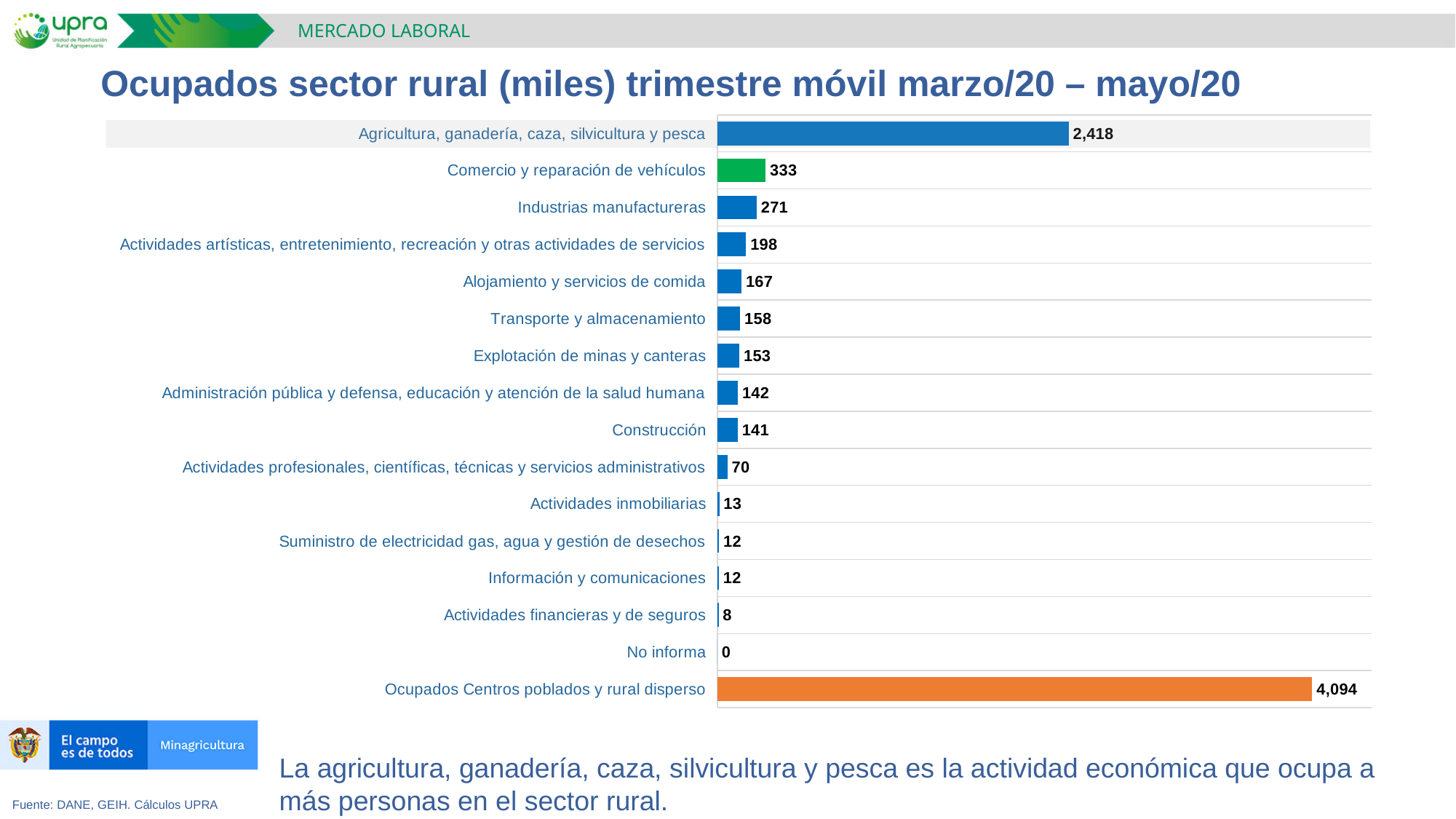
What is the value for Ocupados Centros poblados y rural disperso? 4,094 What is the difference between Industrias manufactureras and Comercio y reparación de vehículos? 62 Which is larger, Transporte y almacenamiento or Explotación de minas y canteras? Transporte y almacenamiento Which category has the lowest value in the chart? No informa What is the value for Construcción? 141 What is the value for Comercio y reparación de vehículos? 333 What is the title of the chart? Ocupados sector rural (miles) trimestre móvil marzo/20 – mayo/20 What colour is the bar for Ocupados Centros poblados y rural disperso? Orange How many categories are shown in the chart? 16 What kind of chart is shown on the slide? Bar chart What is the value for Agricultura, ganadería, caza, silvicultura y pesca? 2,418 Which category has the highest value in the chart? Ocupados Centros poblados y rural disperso